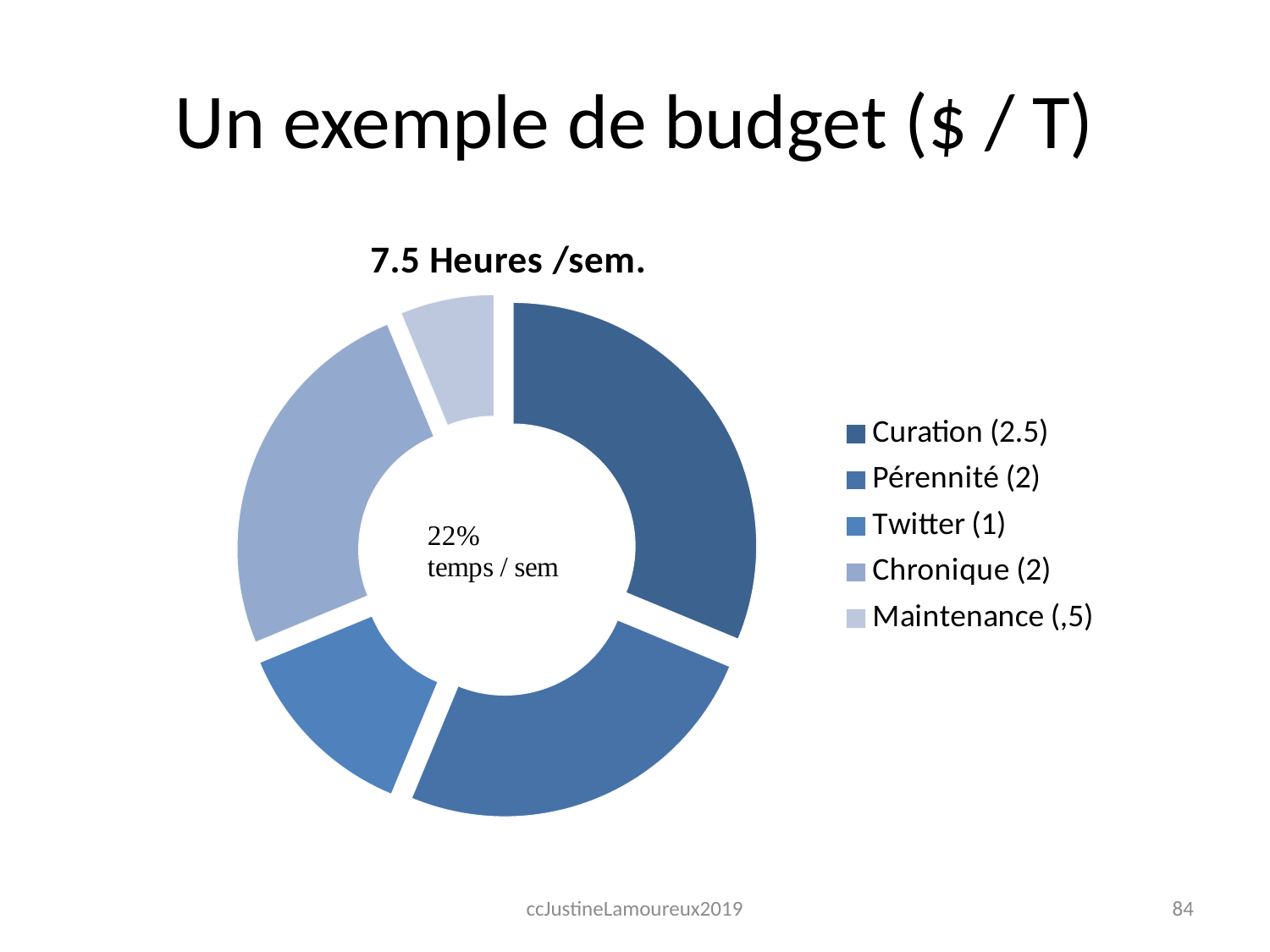
Which is larger, the value for Chronique or the value for Maintenance? Chronique What text is written in the centre of the doughnut chart? 22% temps / sem What is the difference between the value for Curation and the value for Twitter? 1.5 Which category has the largest value in the chart? Curation Which category has the smallest value in the chart? Maintenance Which is larger, the value for Curation or the value for Twitter? Curation What is the title of the chart? 7.5 Heures /sem. How many categories does the chart's legend list? 5 What value is given for Twitter in the legend? 1 What value is given for Maintenance in the legend? ,5 What value is given for Curation in the legend? 2.5 What kind of chart is shown on the slide? doughnut chart